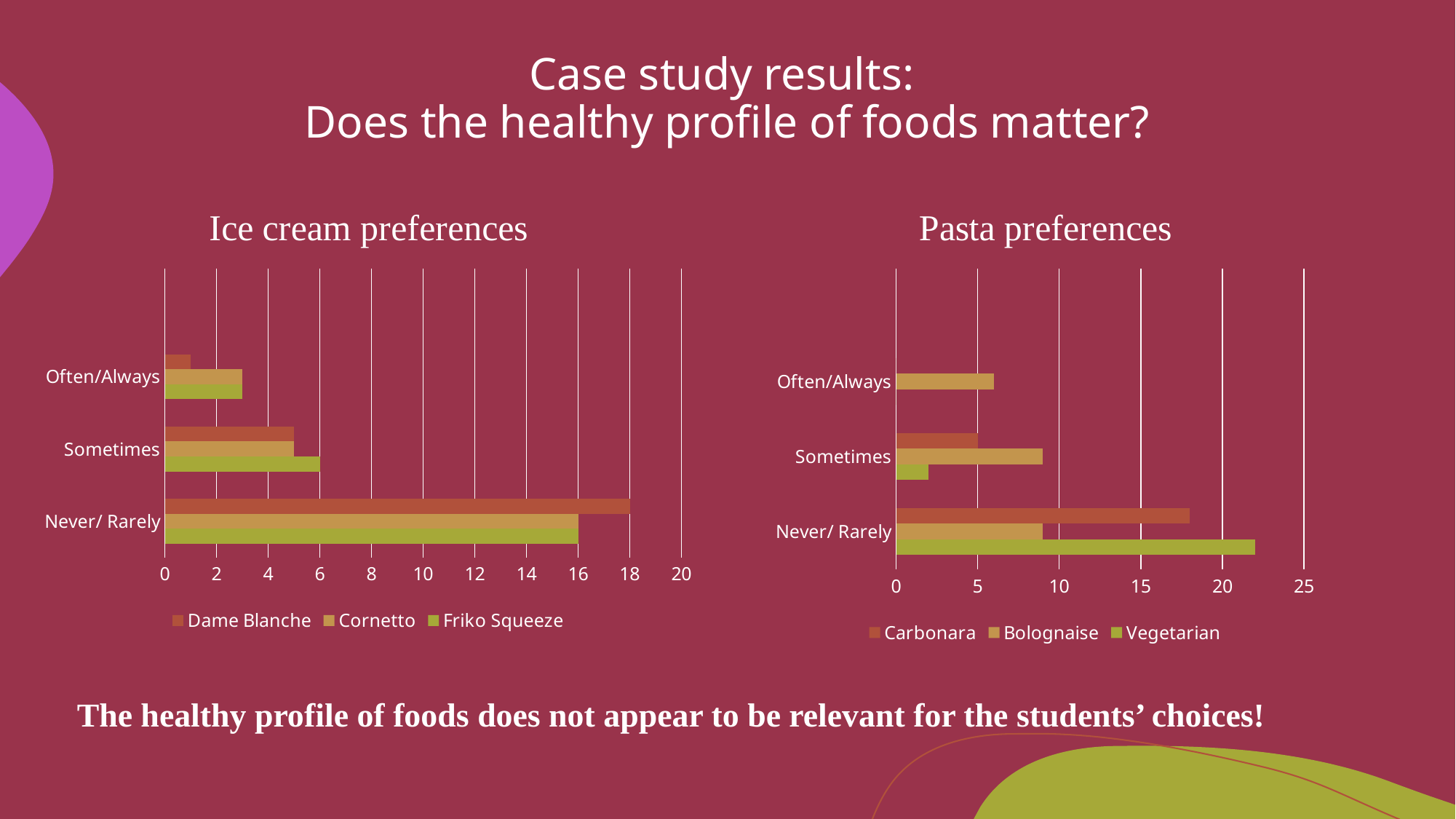
In the Ice cream preferences chart, what is the value for Friko Squeeze in the Sometimes category? 6 How many series does the legend of the Ice cream preferences chart list? 3 In the Pasta preferences chart, is the value for Carbonara in the Never/ Rarely category greater or less than 15? greater In the Ice cream preferences chart, what is the value for Dame Blanche in the Never/ Rarely category? 18 In the Ice cream preferences chart, which category has the highest value for Dame Blanche? Never/ Rarely In the Ice cream preferences chart, what is the difference between Dame Blanche and Cornetto in the Never/ Rarely category? 2 How many categories are shown on the y axis of the Pasta preferences chart? 3 In the Pasta preferences chart, is the value for Vegetarian in the Never/ Rarely category greater or less than 20? greater In the Ice cream preferences chart, what is the value for Cornetto in the Never/ Rarely category? 16 In the Pasta preferences chart, what is the value for Carbonara in the Sometimes category? 5 In the Pasta preferences chart, which series has the highest value in the Never/ Rarely category? Vegetarian What kind of chart is the Ice cream preferences chart? Bar chart